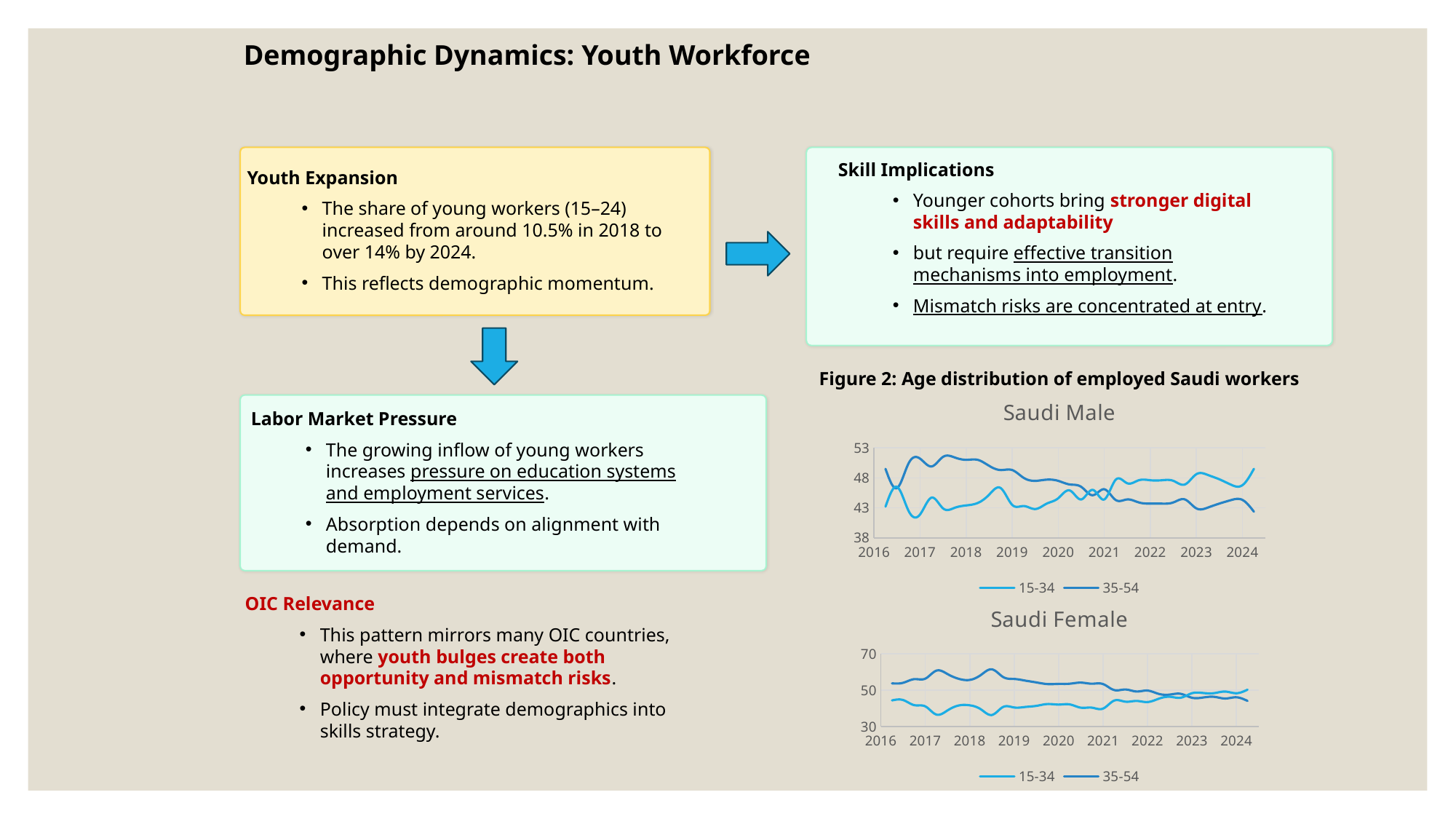
What are the two series named in the legend of the Saudi Male chart? 15-34 and 35-54 In the Saudi Male chart, is the value for the 35-54 series in 2024 greater or less than 48? less In the Saudi Female chart, is the value for the 15-34 series in 2017 greater or less than 50? less In the Saudi Male chart, is the value for the 35-54 series in 2018 greater or less than 48? greater How many series does the legend of the Saudi Female chart list? 2 In the Saudi Female chart, which series is higher in 2018, 15-34 or 35-54? 35-54 What type of chart is the Saudi Male chart? line chart What is the title of the figure containing the two charts? Figure 2: Age distribution of employed Saudi workers How many years are labeled on the x axis of the Saudi Male chart? 9 In the Saudi Male chart, does the 35-54 series rise or fall between 2018 and 2024? fall In the Saudi Male chart, does the 15-34 series rise or fall between 2017 and 2024? rise In the Saudi Female chart, does the 35-54 series rise or fall between 2018 and 2024? fall